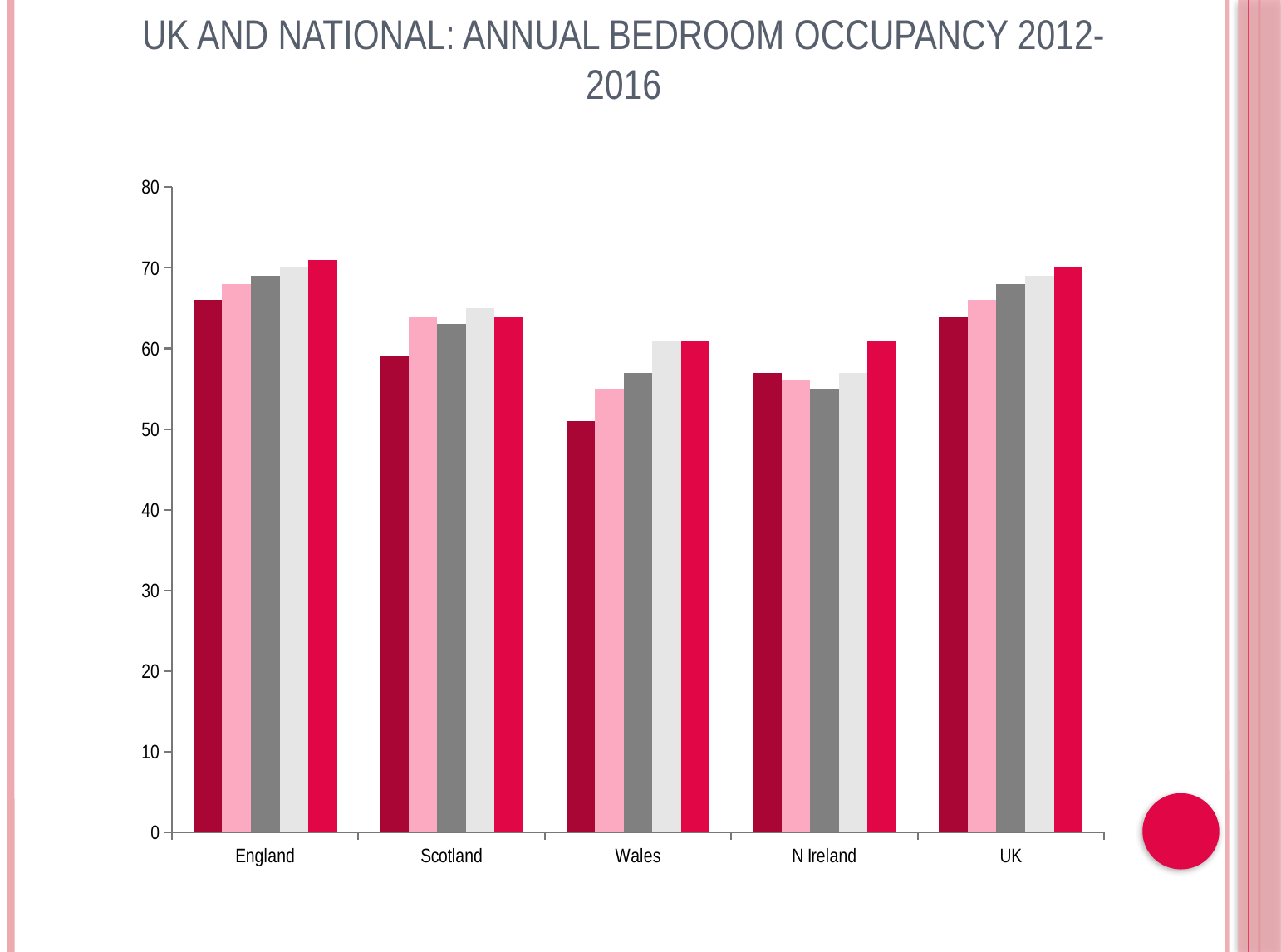
What kind of chart is shown on the slide? bar chart What is the title of the chart on the slide? UK and National: Annual Bedroom Occupancy 2012-2016 Which category has the taller tallest bar, England or Wales? England Is the shortest bar for Wales greater or less than 40? greater Which category contains the shortest bar in the whole chart? Wales Is the shortest bar for N Ireland greater or less than 50? greater How many categories are shown on the x axis of the chart? 5 Is the tallest bar for Wales greater or less than 70? less What is the highest value shown on the y axis of the chart? 80 How many bars are plotted for each category in the chart? 5 Do the bars for England rise or fall from left to right within the group? rise